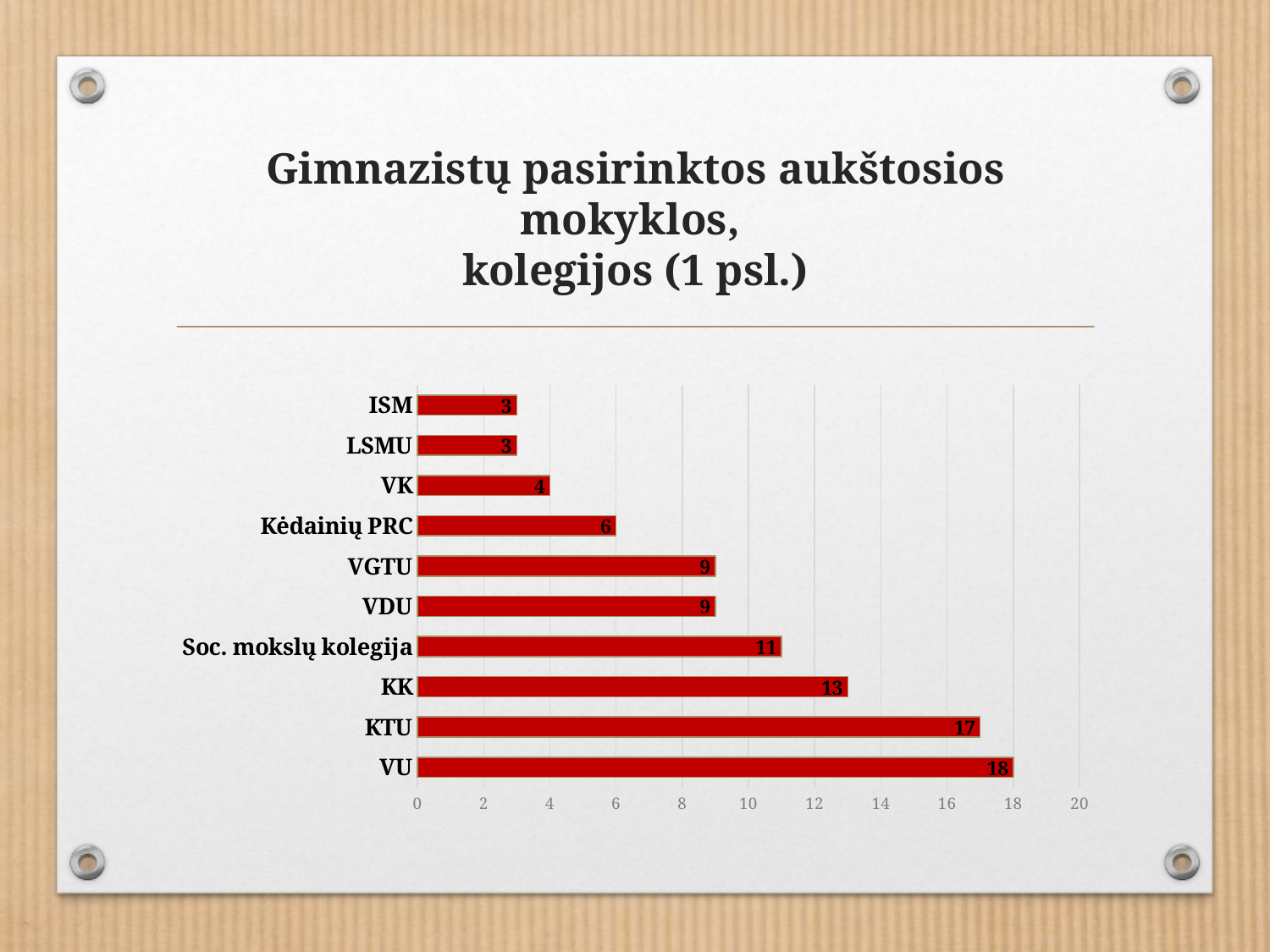
Which category has the highest value? VU What is the value for Soc. mokslų kolegija? 11 Which is larger, the value for VGTU or the value for Kėdainių PRC? VGTU What is the difference between the values for KK and VK? 9 How many categories are shown in the chart? 10 What is the difference between the values for VU and KTU? 1 What kind of chart is shown on the slide? bar chart Is the value for KTU greater or less than 16? greater What is the value for Kėdainių PRC? 6 What colour are the bars in the chart? red What is the value for VU? 18 What is the value for LSMU? 3